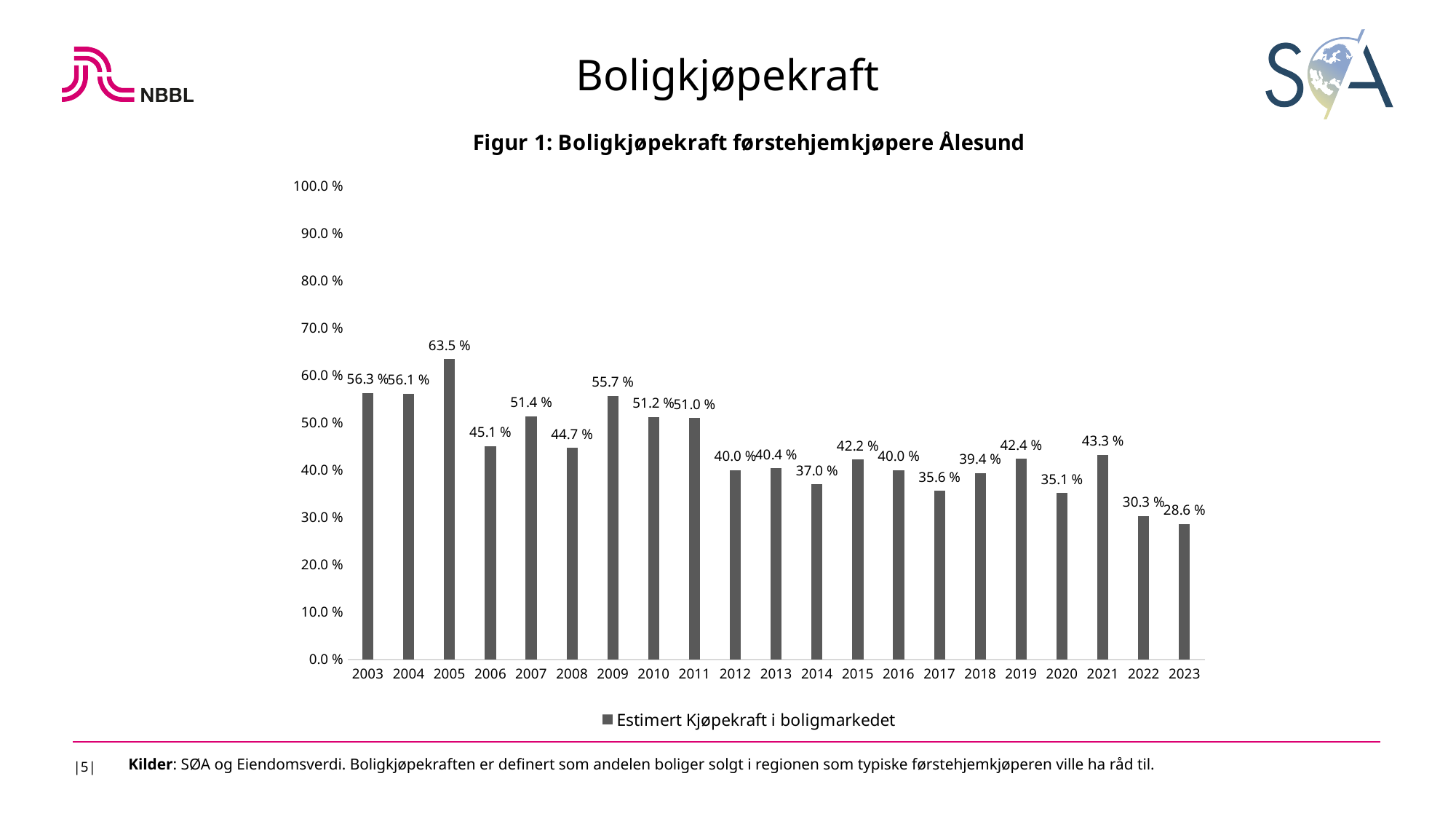
What is the legend entry for the series? Estimert Kjøpekraft i boligmarkedet How many years are shown on the x axis? 21 Which year has the lowest value? 2023 What is the difference between the values for 2005 and 2023? 34.9 % Is the value for 2022 greater or less than 40.0 %? less What kind of chart is shown? bar chart What is the value for 2023? 28.6 % What is the value for 2005? 63.5 % Which is larger, the value for 2009 or the value for 2021? 2009 Which year has the highest value? 2005 How many series does the legend list? 1 What is the value for 2014? 37.0 %